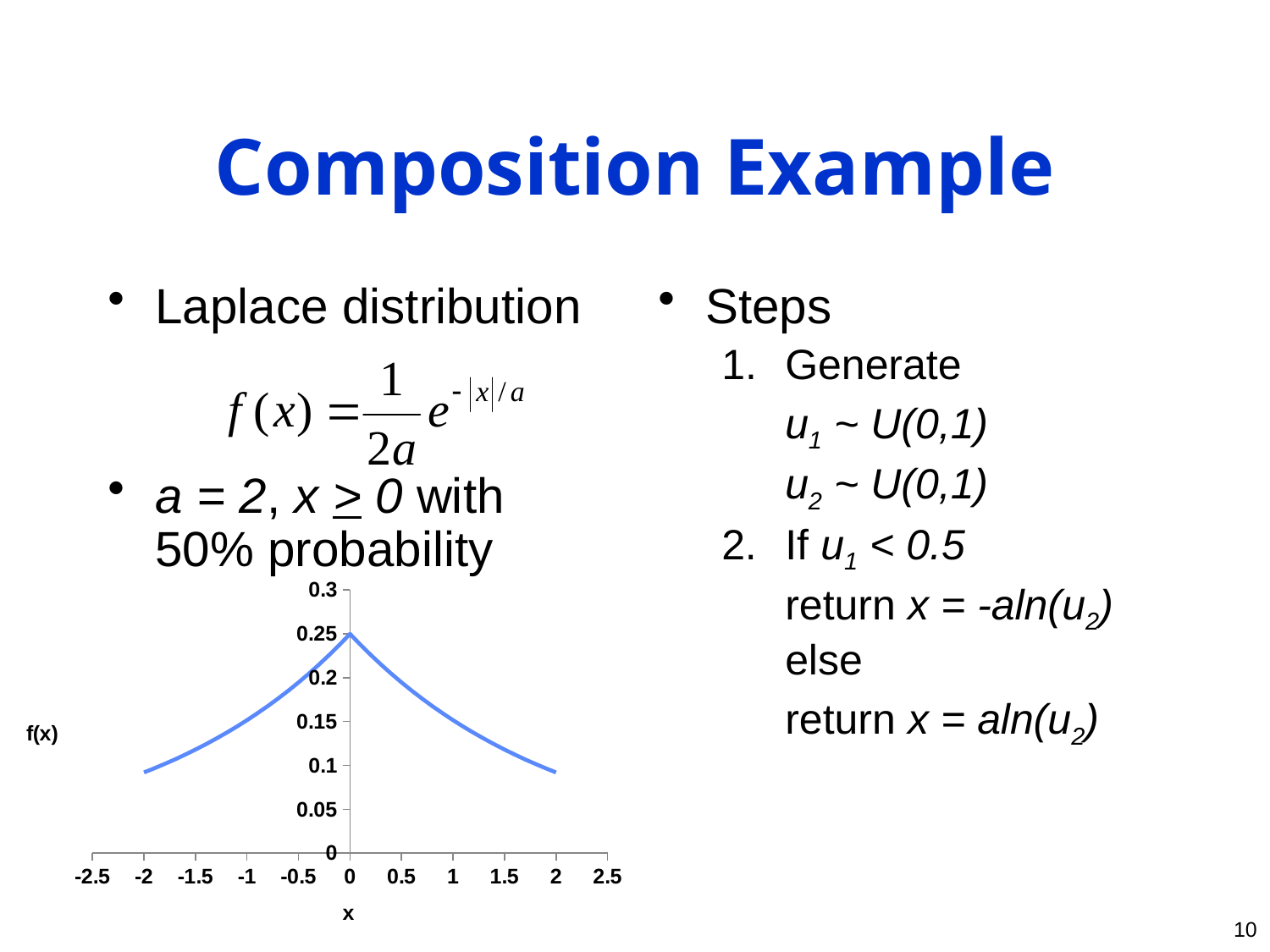
Is the value of f(x) at x = 1.5 greater or less than 0.15? less Is the value of f(x) at x = -2 greater or less than 0.2? less What is the label on the vertical axis of the chart? f(x) Is the value of f(x) at x = 2 greater or less than 0.15? less What is the value of f(x) at x = 0? 0.25 What is the highest tick value shown on the vertical axis? 0.3 Does f(x) rise or fall as x increases from -2 to 0? rise Does f(x) rise or fall as x increases from 0 to 2? fall Which is larger, f(x) at x = 0 or f(x) at x = 2? x = 0 What kind of chart is shown on the slide? line chart At which value of x does f(x) reach its highest point? 0